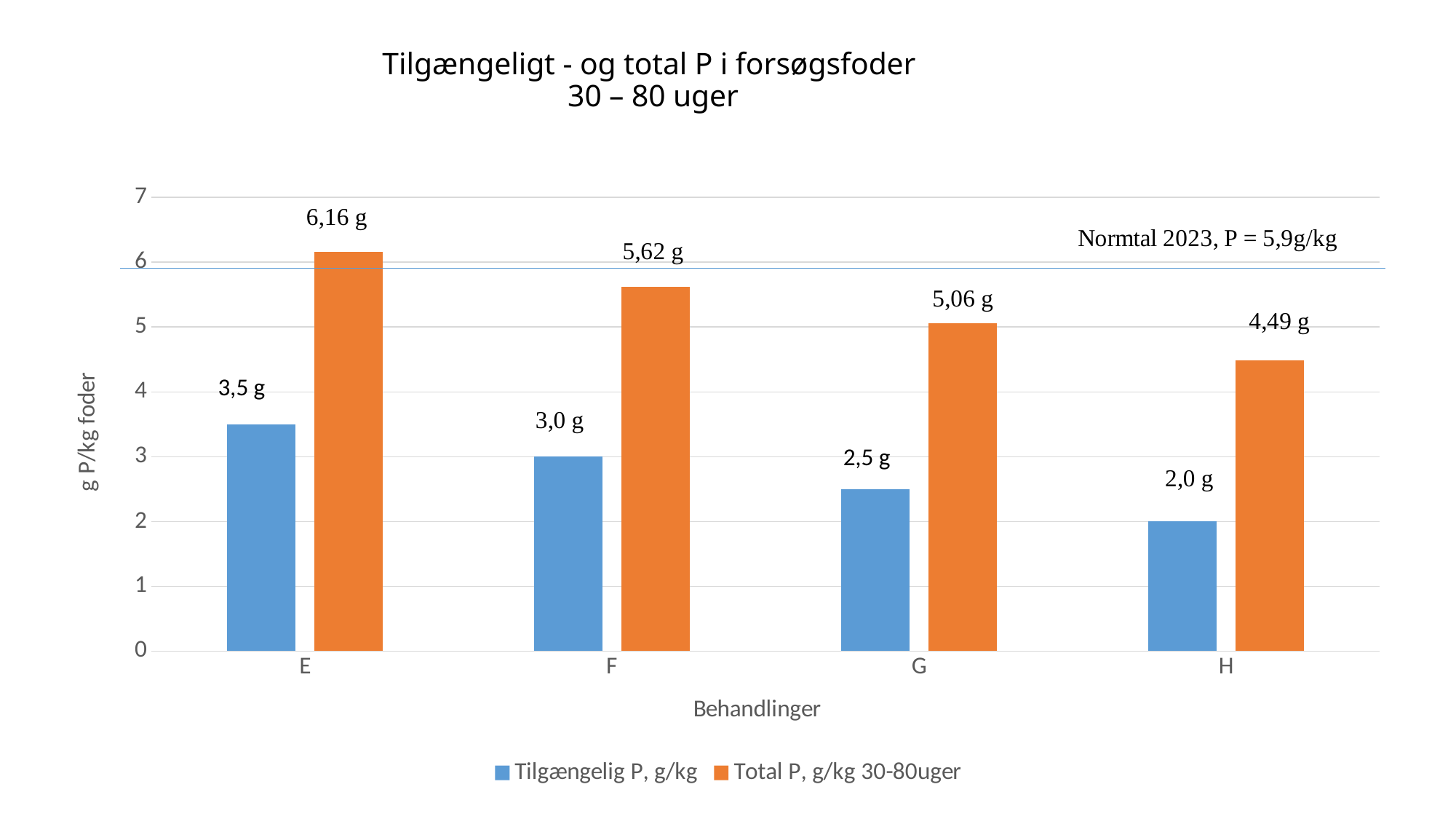
What is the Total P, g/kg 30-80uger value for treatment G? 5,06 g Which treatment has the lowest Tilgængelig P, g/kg value? H What is the Tilgængelig P, g/kg value for treatment E? 3,5 g How many treatments are shown on the x axis? 4 How many series does the legend list? 2 Do the Tilgængelig P, g/kg values rise or fall from treatment E to treatment H? fall Which is larger: the Total P value for treatment F or for treatment G? F Which treatment has the highest Total P, g/kg 30-80uger value? E What is the Total P, g/kg 30-80uger value for treatment H? 4,49 g What kind of chart is shown on the slide? bar chart What is the difference between the Total P values for treatments E and F? 0,54 g Is the Total P value for treatment H greater or less than 5? less